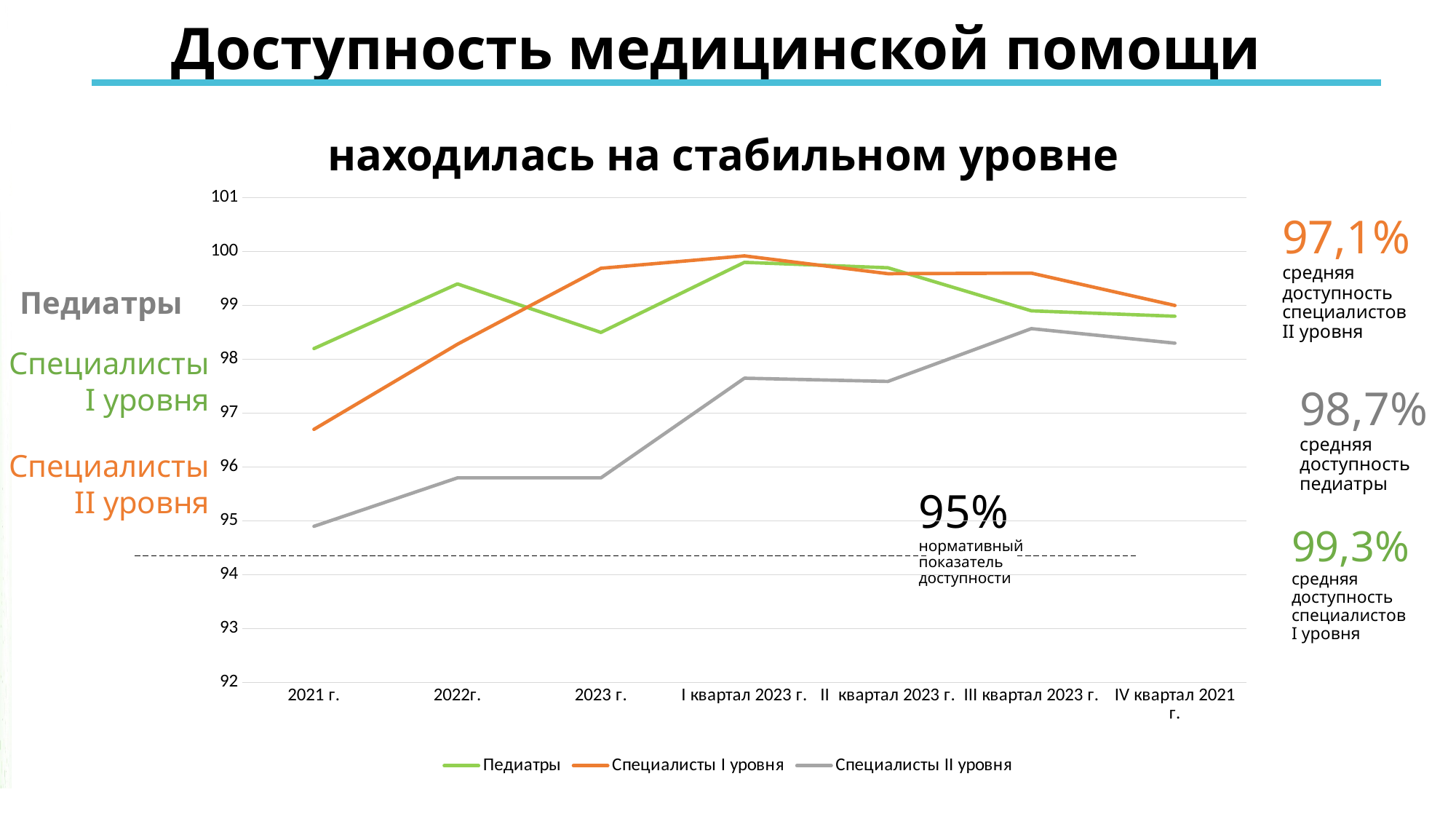
Is the value for Специалисты I уровня at 2021 г. greater or less than 97? less Does the Специалисты II уровня line rise or fall from 2021 г. to III квартал 2023 г.? rise Is the value for Педиатры at 2021 г. greater or less than 97? greater Which series has the lowest value at 2022г.? Специалисты II уровня Is the value for Специалисты II уровня at 2022г. greater or less than 95? greater How many points are there along the x axis of the chart? 7 Which series is shown in orange in the chart legend? Специалисты I уровня How many series does the chart legend list? 3 At 2021 г., which is higher: Педиатры or Специалисты II уровня? Педиатры What kind of chart is shown on the slide? line chart What value is marked by the dashed line labelled 'нормативный показатель доступности'? 95%